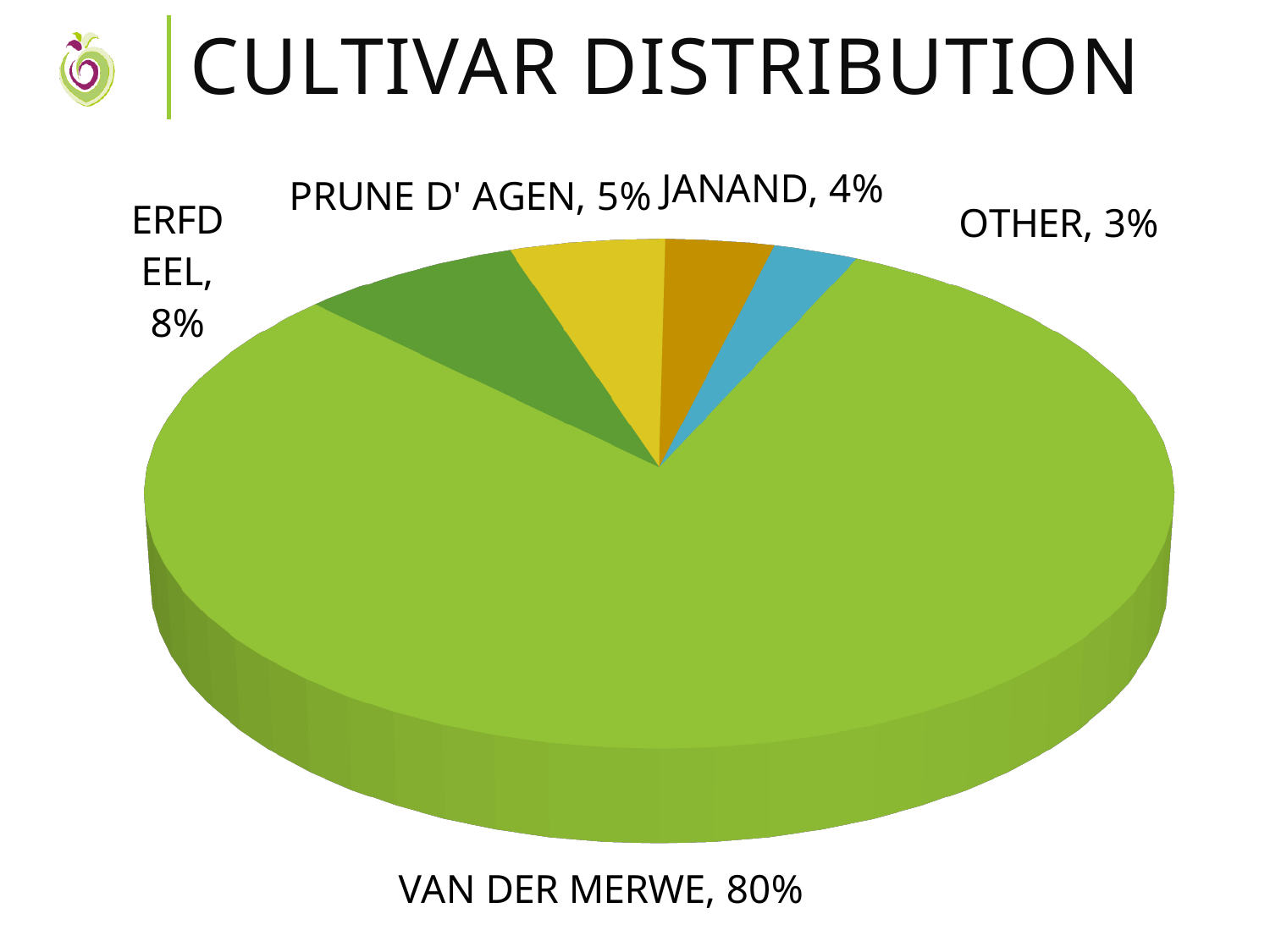
What is the value shown for OTHER? 3% What is the value shown for JANAND? 4% What share of the pie does VAN DER MERWE hold? 80% What is the value shown for ERFDEEL? 8% What kind of chart is shown on the slide? Pie chart What is the title of the chart? CULTIVAR DISTRIBUTION What is the value shown for PRUNE D' AGEN? 5% How many slices does the pie chart have? 5 Which cultivar has the largest share of the pie? VAN DER MERWE Which is larger, the share for PRUNE D' AGEN or the share for JANAND? PRUNE D' AGEN What is the difference between the shares of VAN DER MERWE and ERFDEEL? 72% Which cultivar has the smallest share of the pie? OTHER